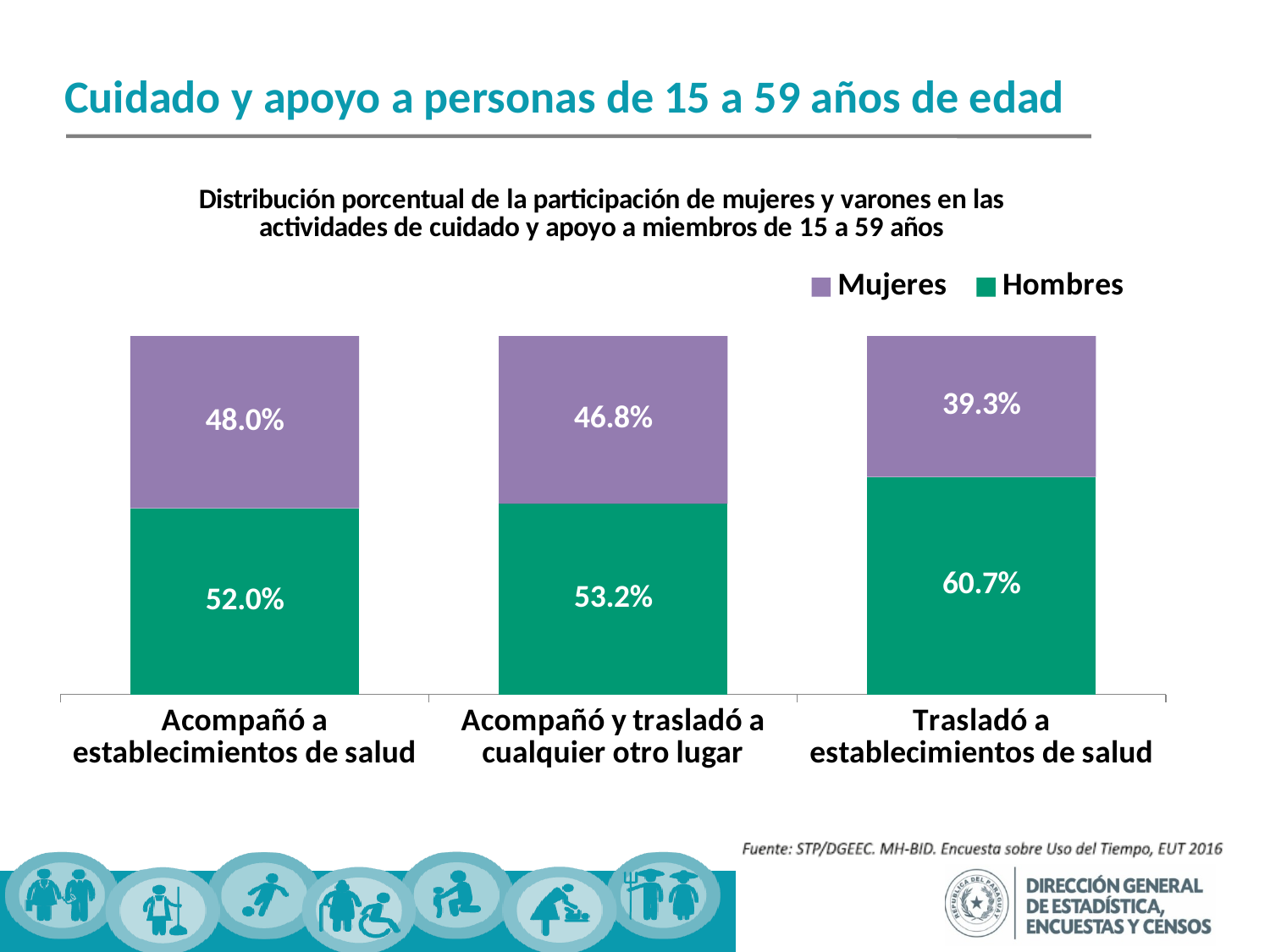
What kind of chart is shown on the slide? Stacked bar chart What is the value for Hombres in the 'Trasladó a establecimientos de salud' category? 60.7% What is the value for Hombres in the 'Acompañó y trasladó a cualquier otro lugar' category? 53.2% In which category is the Mujeres value lowest? Trasladó a establecimientos de salud How many categories are shown on the x axis? 3 What is the total of the stacked bar for 'Acompañó y trasladó a cualquier otro lugar'? 100.0% In which category is the Hombres value highest? Trasladó a establecimientos de salud What is the difference between the Hombres and Mujeres values in the 'Trasladó a establecimientos de salud' category? 21.4% Which colour represents the Mujeres series in the legend? Purple How many series does the legend list? 2 What is the value for Mujeres in the 'Acompañó a establecimientos de salud' category? 48.0% Which is larger in the 'Acompañó a establecimientos de salud' category, the Mujeres value or the Hombres value? Hombres